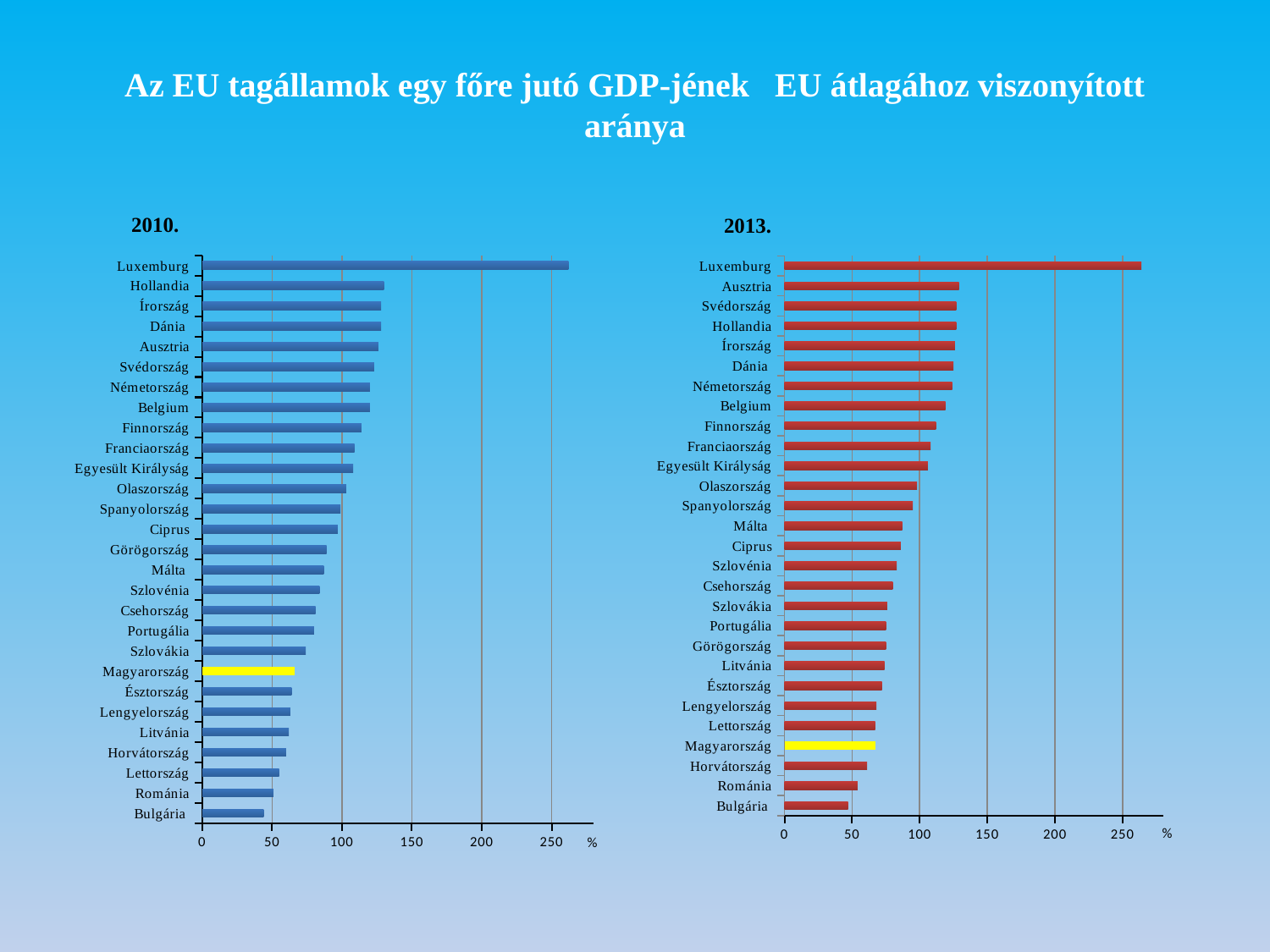
What kind of chart is the 2010 chart? bar chart In the 2013 chart, is the value for Luxemburg greater or less than 250? greater In the 2010 chart, which country has the highest value? Luxemburg In the 2010 chart, is the value for Hollandia greater or less than 100? greater In the 2010 chart, is the value for Magyarország greater or less than 100? less In the 2013 chart, which is larger, the value for Ausztria or the value for Románia? Ausztria In the 2013 chart, which country's bar is highlighted in yellow? Magyarország In the 2013 chart, which country has the lowest value? Bulgária In the 2010 chart, which country has the lowest value? Bulgária In the 2010 chart, which is larger, the value for Görögország or the value for Lettország? Görögország How many countries are shown in the 2013 chart? 28